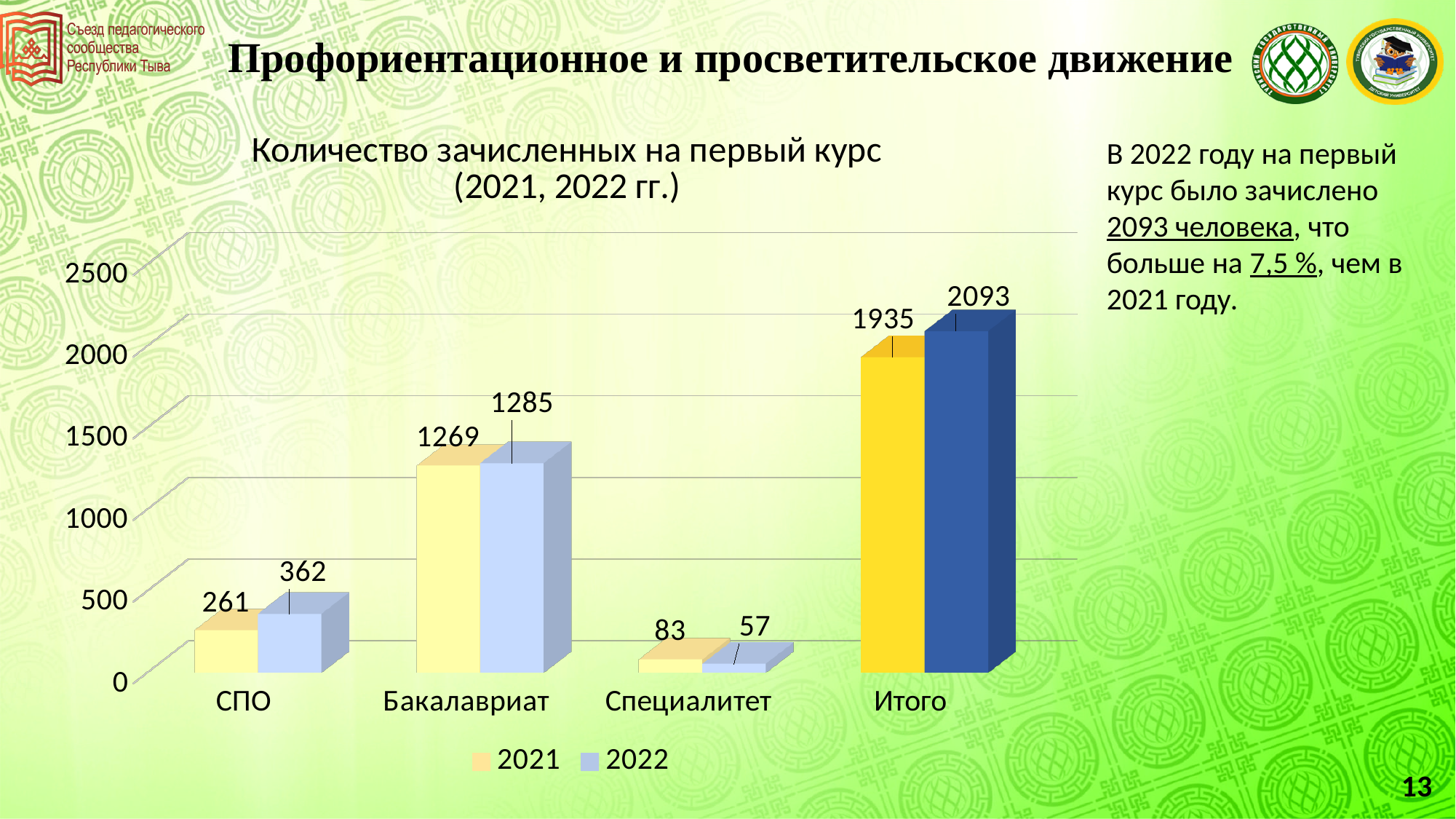
What is the value for СПО in 2022? 362 What type of chart is shown on the slide? Bar chart Excluding Итого, which category has the highest value in 2021? Бакалавриат Which category has the lowest value in the 2022 series? Специалитет What is the difference between the 2022 and 2021 values for Итого? 158 For Специалитет, which year has the larger value, 2021 or 2022? 2021 What is the difference between the 2022 and 2021 values for СПО? 101 What is the value for Итого in 2021? 1935 How many categories are shown on the x axis? 4 How many series does the legend list? 2 What is the value for Специалитет in 2022? 57 What is the value for Бакалавриат in 2021? 1269